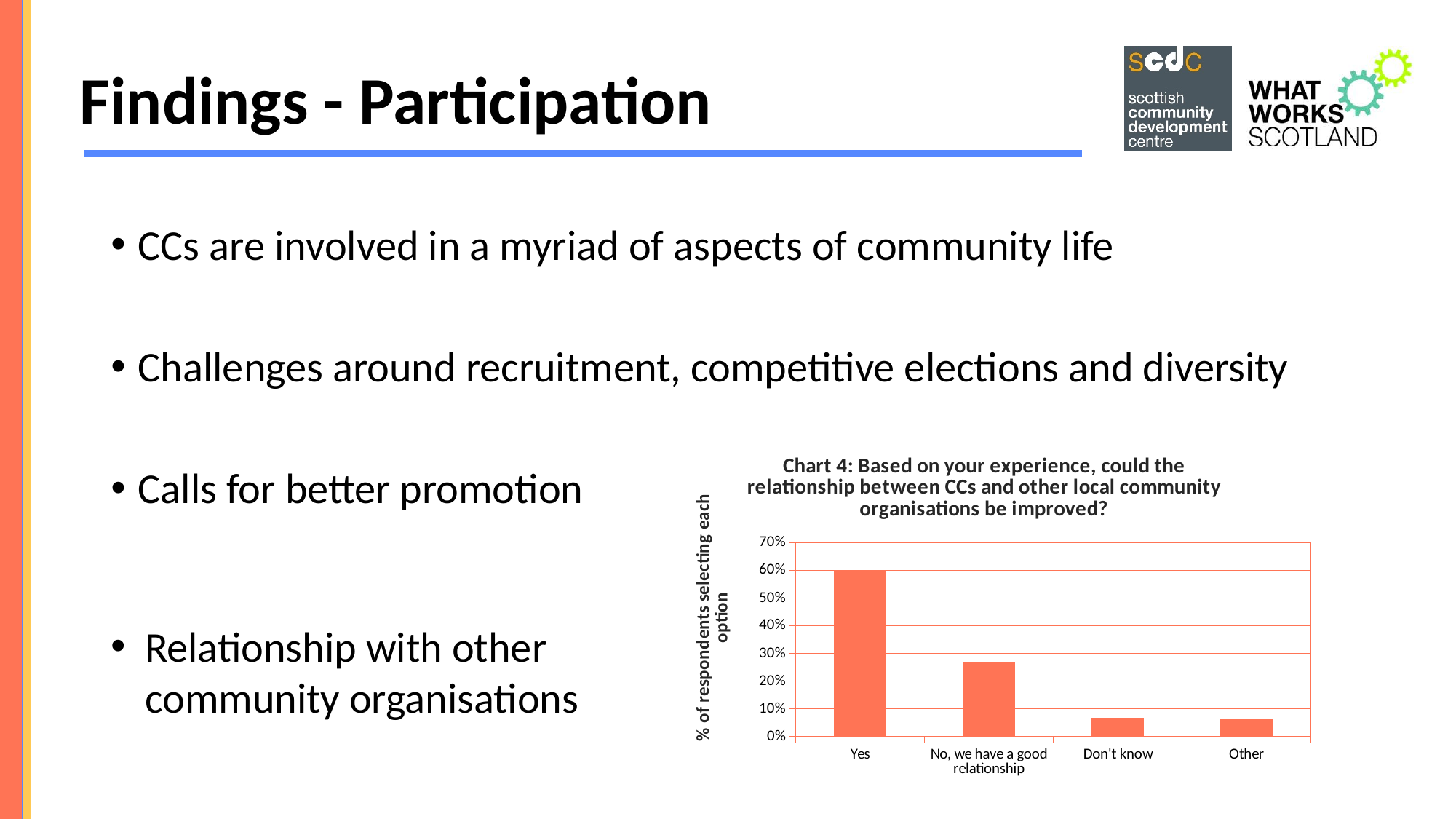
In Chart 4, is the value for 'No, we have a good relationship' greater or less than 20%? greater In Chart 4, which is larger, the value for 'No, we have a good relationship' or the value for Don't know? No, we have a good relationship In Chart 4, is the value for 'No, we have a good relationship' greater or less than 30%? less How many categories are shown on the x axis of Chart 4? 4 What is the highest value shown on the y axis of Chart 4? 70% Which category has the highest value in Chart 4? Yes What is the y-axis label of Chart 4? % of respondents selecting each option In Chart 4, is the value for Don't know greater or less than 10%? less In Chart 4, what is the value for Yes? 60% In Chart 4, which is larger, the value for Yes or the value for 'No, we have a good relationship'? Yes What type of chart is Chart 4? bar chart